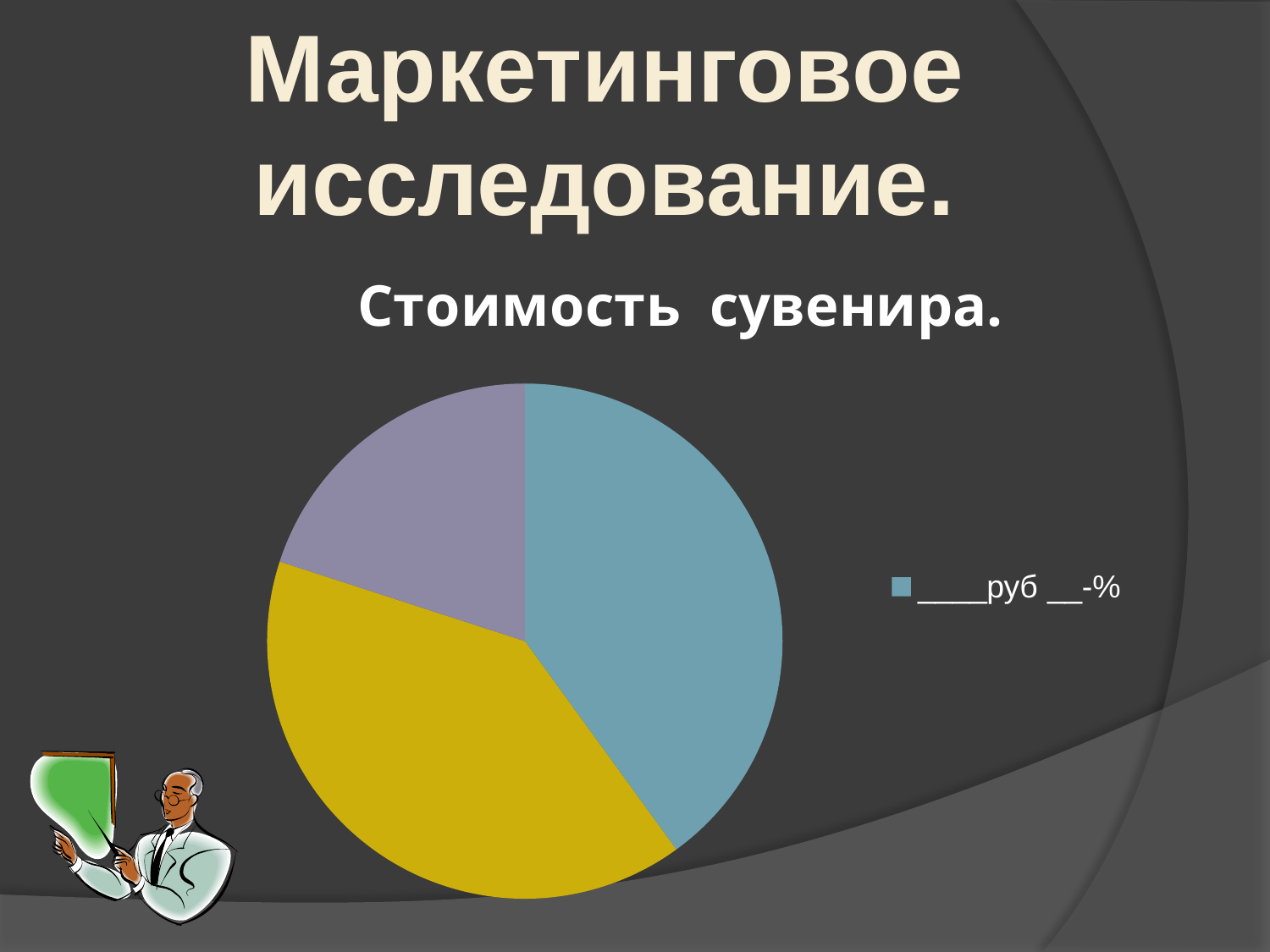
Which slice of the pie chart is the smallest? the purple slice What kind of chart is shown on the slide? pie chart How many slices does the pie chart have? 3 What is the title of the pie chart? Стоимость сувенира. Which is larger in the pie chart, the blue slice or the purple slice? the blue slice Which is larger in the pie chart, the yellow slice or the purple slice? the yellow slice What text does the legend entry of the pie chart show? ____руб __-% How many entries does the legend of the pie chart list? 1